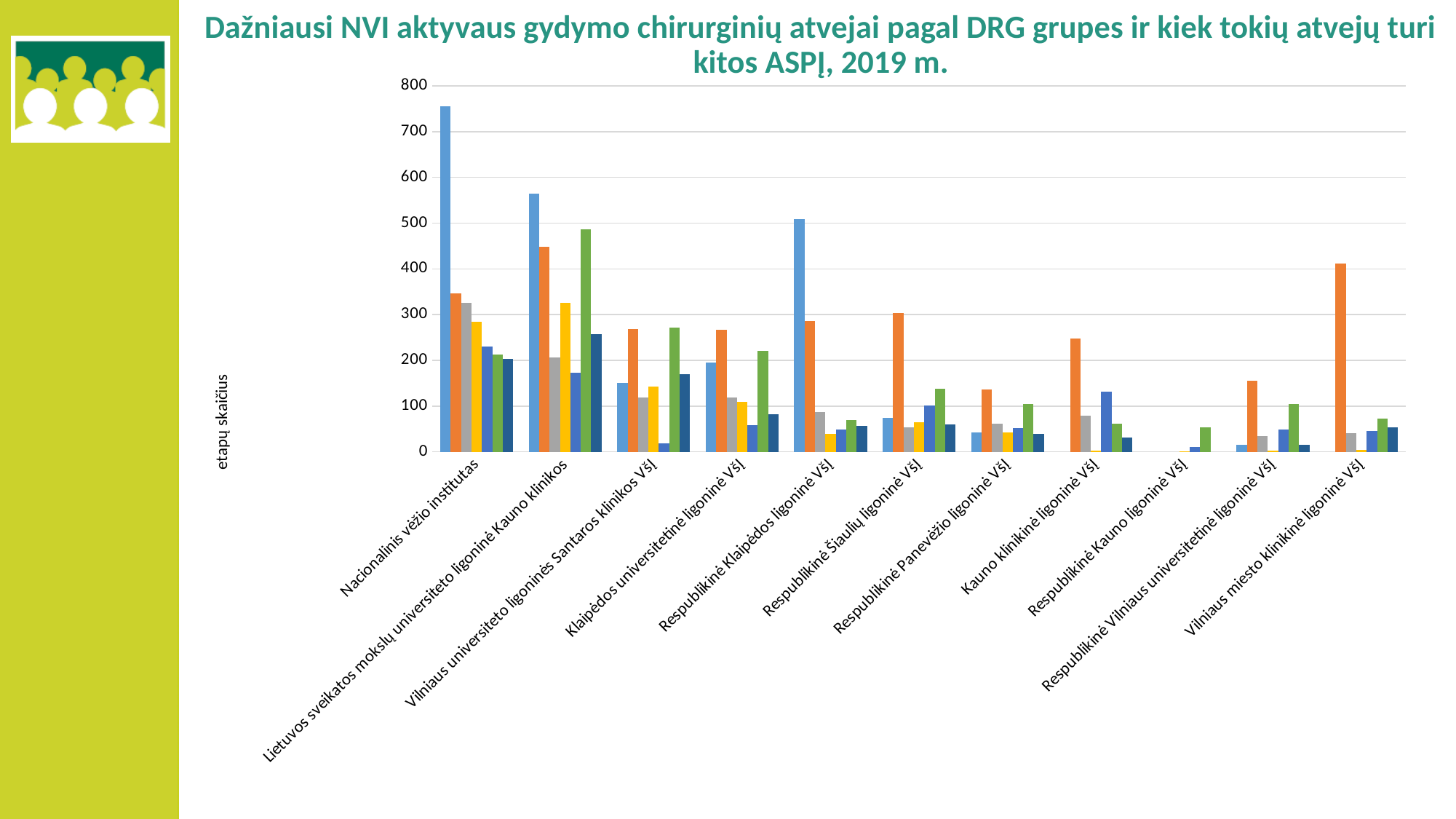
What kind of chart is shown on the slide? bar chart Which hospital has the tallest bar in the chart? Nacionalinis vėžio institutas Is the orange bar for Vilniaus miesto klinikinė ligoninė VšĮ greater or less than 300? greater Which has the larger orange bar: Respublikinė Šiaulių ligoninė VšĮ or Respublikinė Panevėžio ligoninė VšĮ? Respublikinė Šiaulių ligoninė VšĮ What is the highest value shown on the vertical axis? 800 Which has the taller light blue bar: Nacionalinis vėžio institutas or Lietuvos sveikatos mokslų universiteto ligoninė Kauno klinikos? Nacionalinis vėžio institutas Is the green bar for Lietuvos sveikatos mokslų universiteto ligoninė Kauno klinikos greater or less than 400? greater How many hospitals (categories) are shown along the x axis? 11 What is the label of the vertical axis? etapų skaičius Is the tallest (light blue) bar for Nacionalinis vėžio institutas greater or less than 700? greater